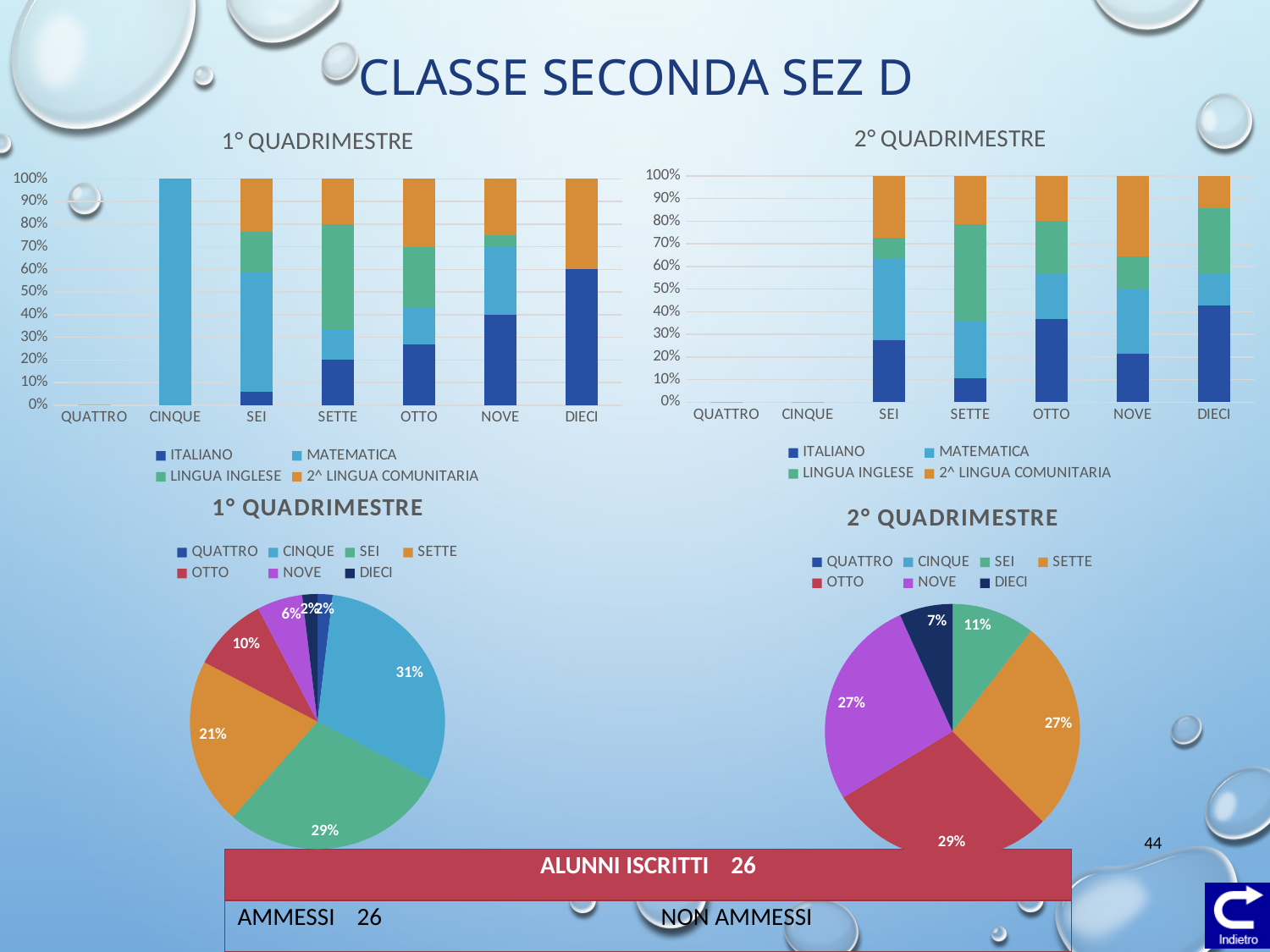
How many categories are shown on the x axis of the top-right bar chart (2° QUADRIMESTRE)? 7 What kind of chart is the top-left chart titled 1° QUADRIMESTRE? Stacked bar chart In the bottom-left pie chart (1° QUADRIMESTRE), what share does CINQUE have? 31% In the bottom-right pie chart (2° QUADRIMESTRE), what share does DIECI have? 7% In the top-left bar chart (1° QUADRIMESTRE), is the ITALIANO value for DIECI greater or less than 50%? greater How many series does the legend of the top-left bar chart (1° QUADRIMESTRE) list? 4 In the bottom-left pie chart (1° QUADRIMESTRE), what is the difference between the shares of SEI and OTTO? 19% In the top-right bar chart (2° QUADRIMESTRE), is the ITALIANO value for SETTE greater or less than 20%? less In the bottom-left pie chart (1° QUADRIMESTRE), which is larger, the share of SETTE or the share of NOVE? SETTE In the bottom-right pie chart (2° QUADRIMESTRE), what share does OTTO have? 29% In the bottom-right pie chart (2° QUADRIMESTRE), which category has the largest slice? OTTO In the bottom-left pie chart (1° QUADRIMESTRE), what share does SETTE have? 21%